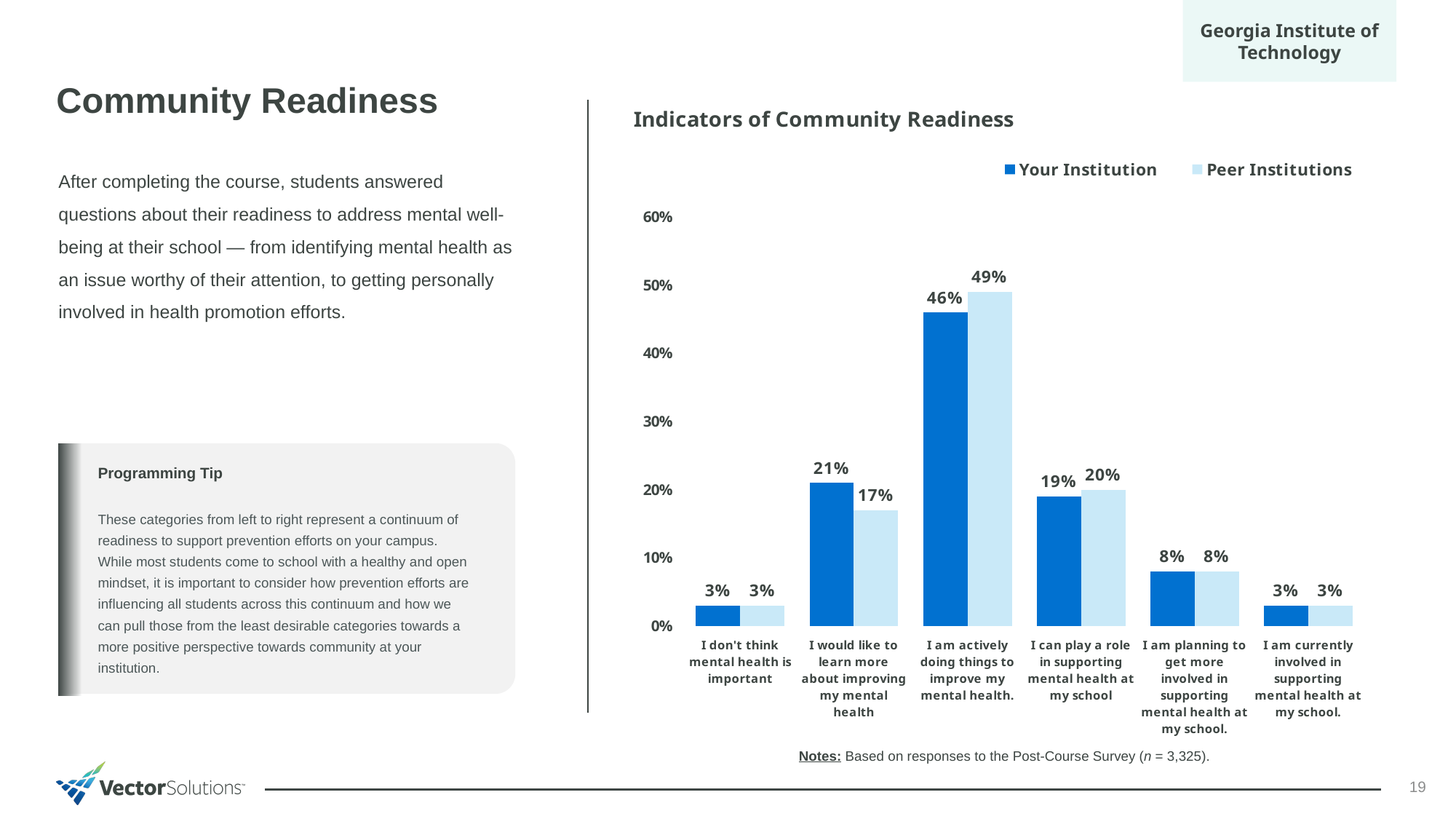
For "I can play a role in supporting mental health at my school", which is larger: Your Institution or Peer Institutions? Peer Institutions What is the difference between Peer Institutions and Your Institution for "I am actively doing things to improve my mental health."? 3% How many series does the legend list? 2 What is the title of the chart? Indicators of Community Readiness Which category has the highest value for Your Institution? I am actively doing things to improve my mental health. What is the value for Your Institution for "I am actively doing things to improve my mental health."? 46% What kind of chart is shown? Bar chart What is the value for Peer Institutions for "I am planning to get more involved in supporting mental health at my school."? 8% What is the value for Your Institution for "I can play a role in supporting mental health at my school"? 19% How many categories are shown on the x axis? 6 What is the value for Peer Institutions for "I would like to learn more about improving my mental health"? 17% What is the difference between Your Institution and Peer Institutions for "I would like to learn more about improving my mental health"? 4%